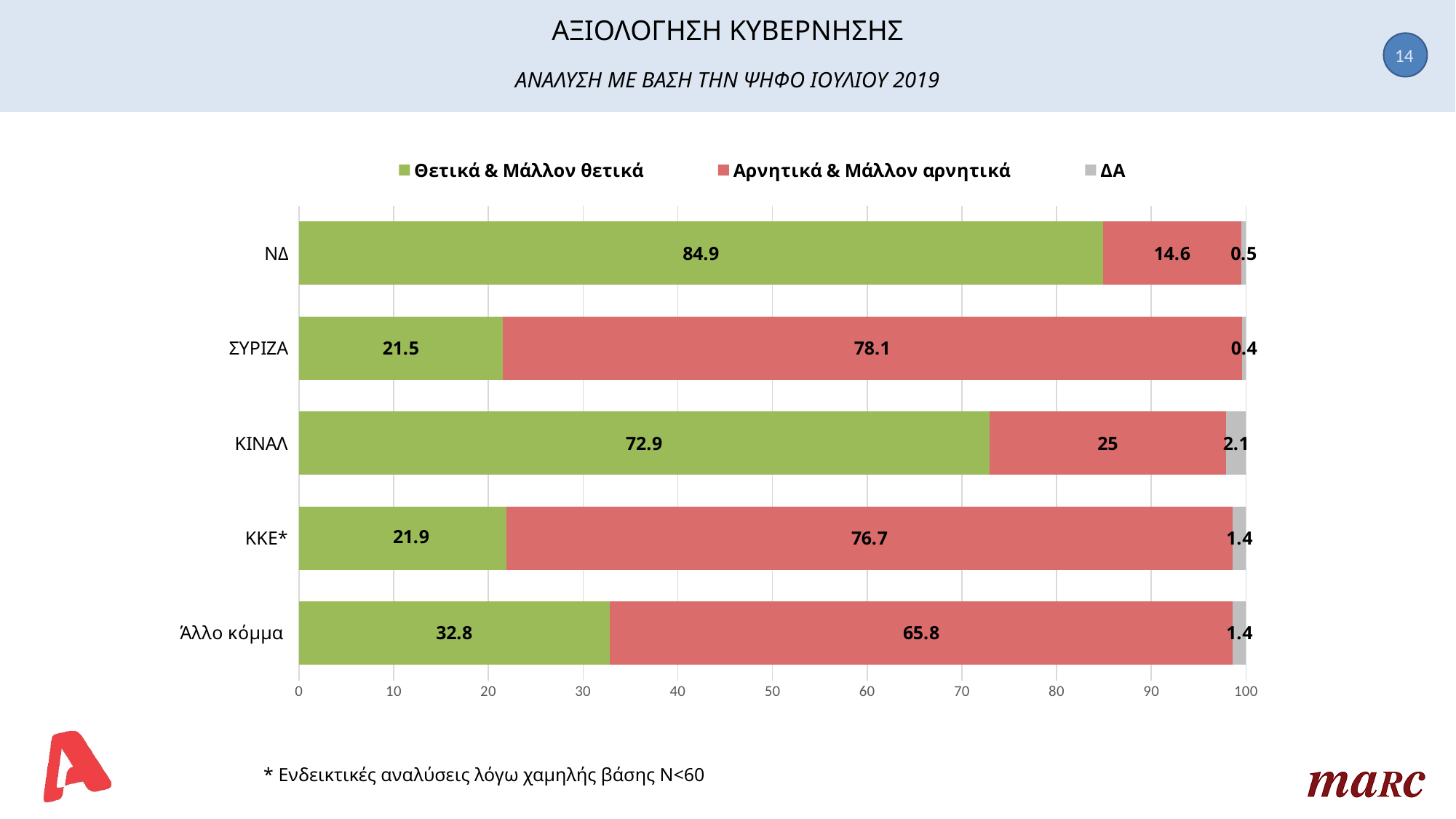
Which category has the highest ΔΑ value? ΚΙΝΑΛ How many categories are shown on the chart? 5 What is the difference between the Θετικά & Μάλλον θετικά values for ΝΔ and ΚΙΝΑΛ? 12 Which category has the lowest value for Αρνητικά & Μάλλον αρνητικά? ΝΔ What is the value of Αρνητικά & Μάλλον αρνητικά for ΣΥΡΙΖΑ? 78.1 Which has a larger Θετικά & Μάλλον θετικά value, ΚΙΝΑΛ or Άλλο κόμμα? ΚΙΝΑΛ What kind of chart is shown on the slide? Stacked bar chart What is the value of Θετικά & Μάλλον θετικά for ΝΔ? 84.9 What is the ΔΑ value for ΚΙΝΑΛ? 2.1 What is the value of Θετικά & Μάλλον θετικά for Άλλο κόμμα? 32.8 Which category has the highest value for Θετικά & Μάλλον θετικά? ΝΔ How many series does the legend list? 3